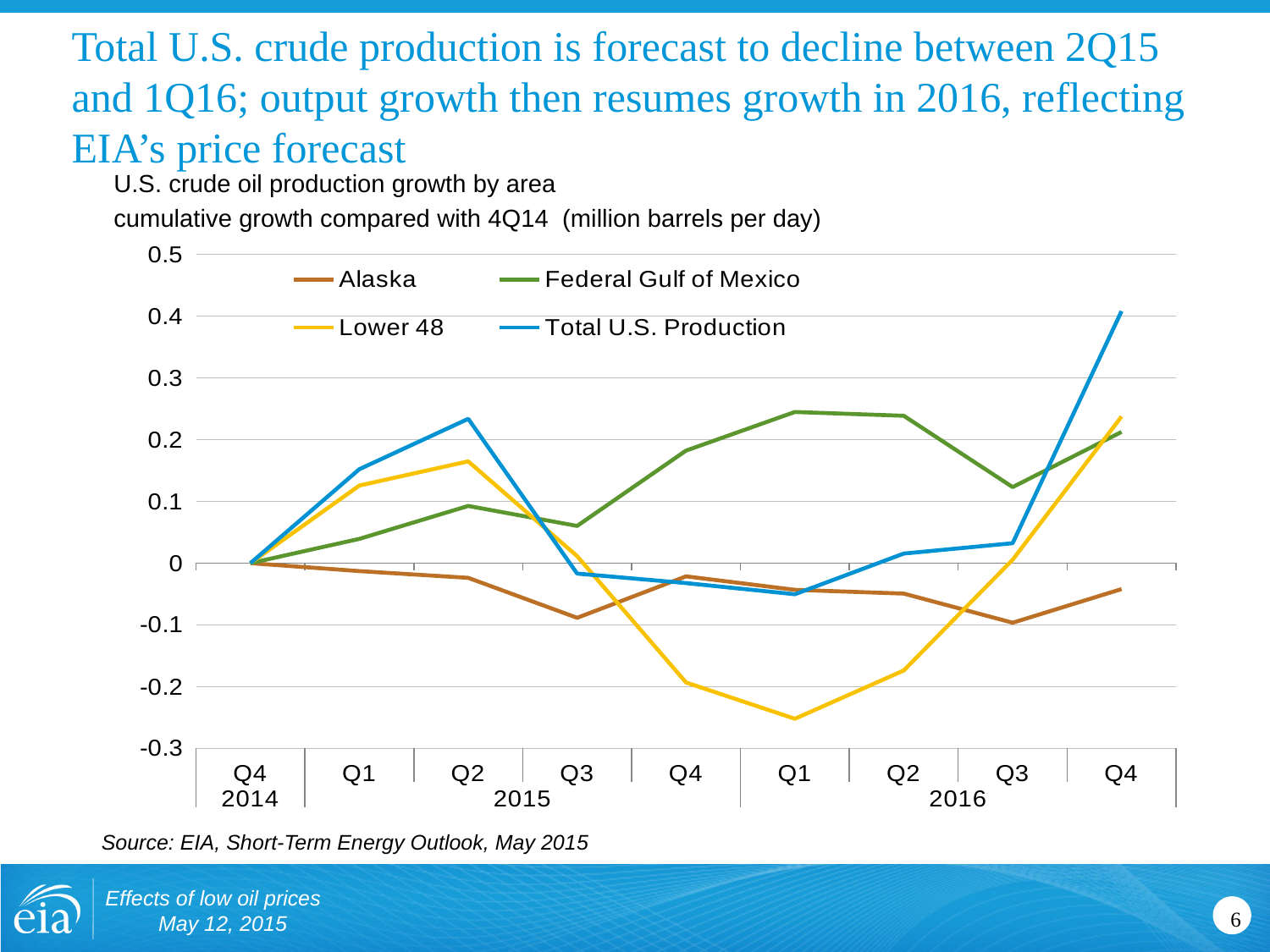
Is the value for Federal Gulf of Mexico in Q1 2016 greater or less than 0.2? greater What is the value for Total U.S. Production in Q4 2014? 0 What kind of chart is shown on the slide? line chart In Q2 2015, which is larger: Total U.S. Production or Alaska? Total U.S. Production How many series does the legend list? 4 Does the Lower 48 line rise or fall from Q1 2016 to Q4 2016? rise Is the value for Total U.S. Production in Q4 2016 greater or less than 0.3? greater Which series has the highest value in Q4 2016? Total U.S. Production What unit is the cumulative growth measured in, according to the chart subtitle? million barrels per day Is the value for Lower 48 in Q1 2016 greater or less than -0.2? less How many quarters are plotted along the x axis? 9 Which series has the lowest value in Q1 2016? Lower 48